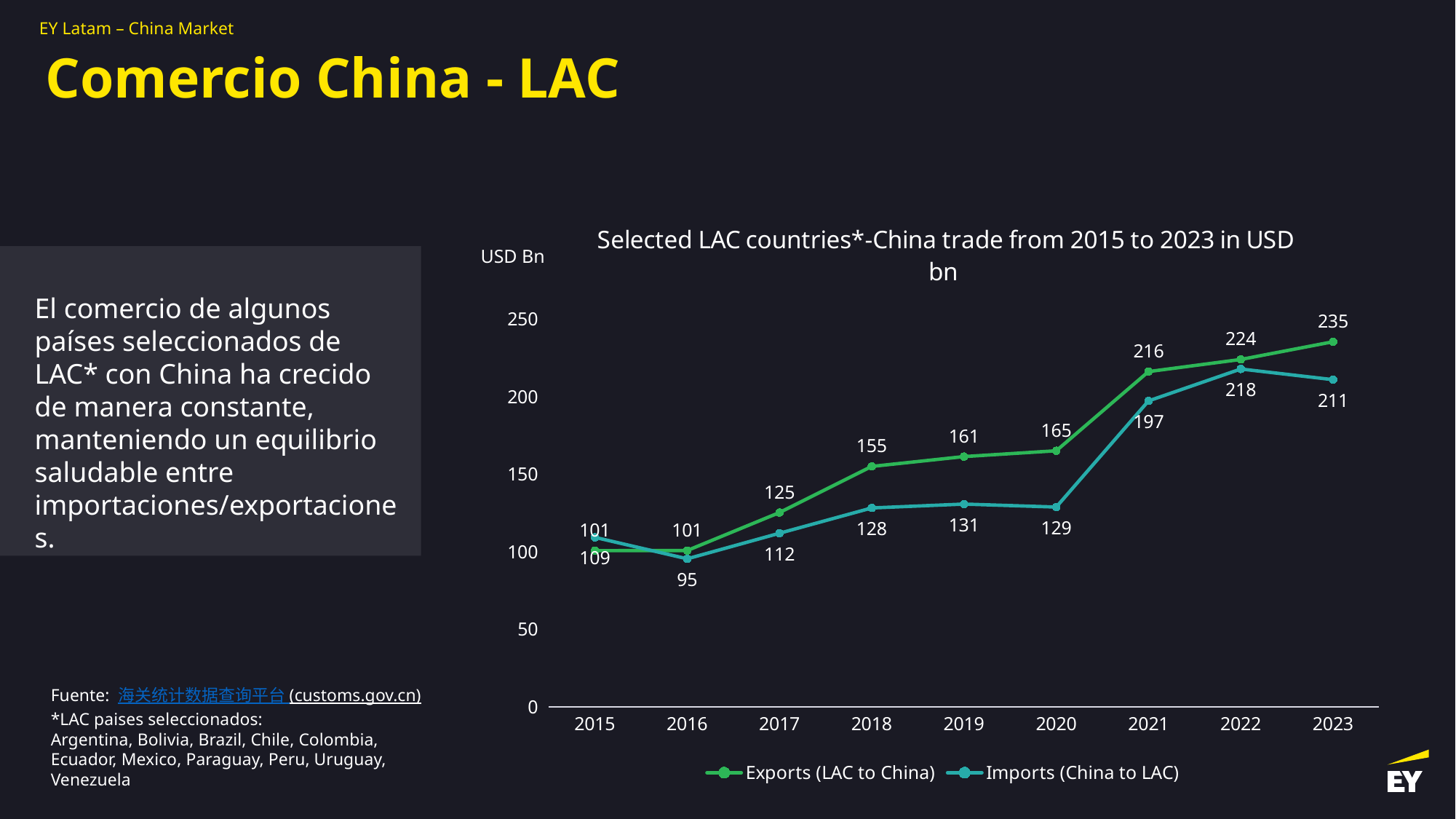
Do Exports (LAC to China) generally rise or fall from 2016 to 2023? Rise What was the value of Exports (LAC to China) in 2023? 235 How many years are shown on the x axis? 9 How many series does the legend list? 2 What type of chart is shown on the slide? Line chart Which was larger in 2015, Exports (LAC to China) or Imports (China to LAC)? Imports (China to LAC) What is the difference between Exports (LAC to China) and Imports (China to LAC) in 2023? 24 In which year were Exports (LAC to China) highest? 2023 What was the value of Imports (China to LAC) in 2016? 95 In which year were Imports (China to LAC) lowest? 2016 What was the value of Imports (China to LAC) in 2021? 197 What unit is shown on the y axis of the chart? USD Bn